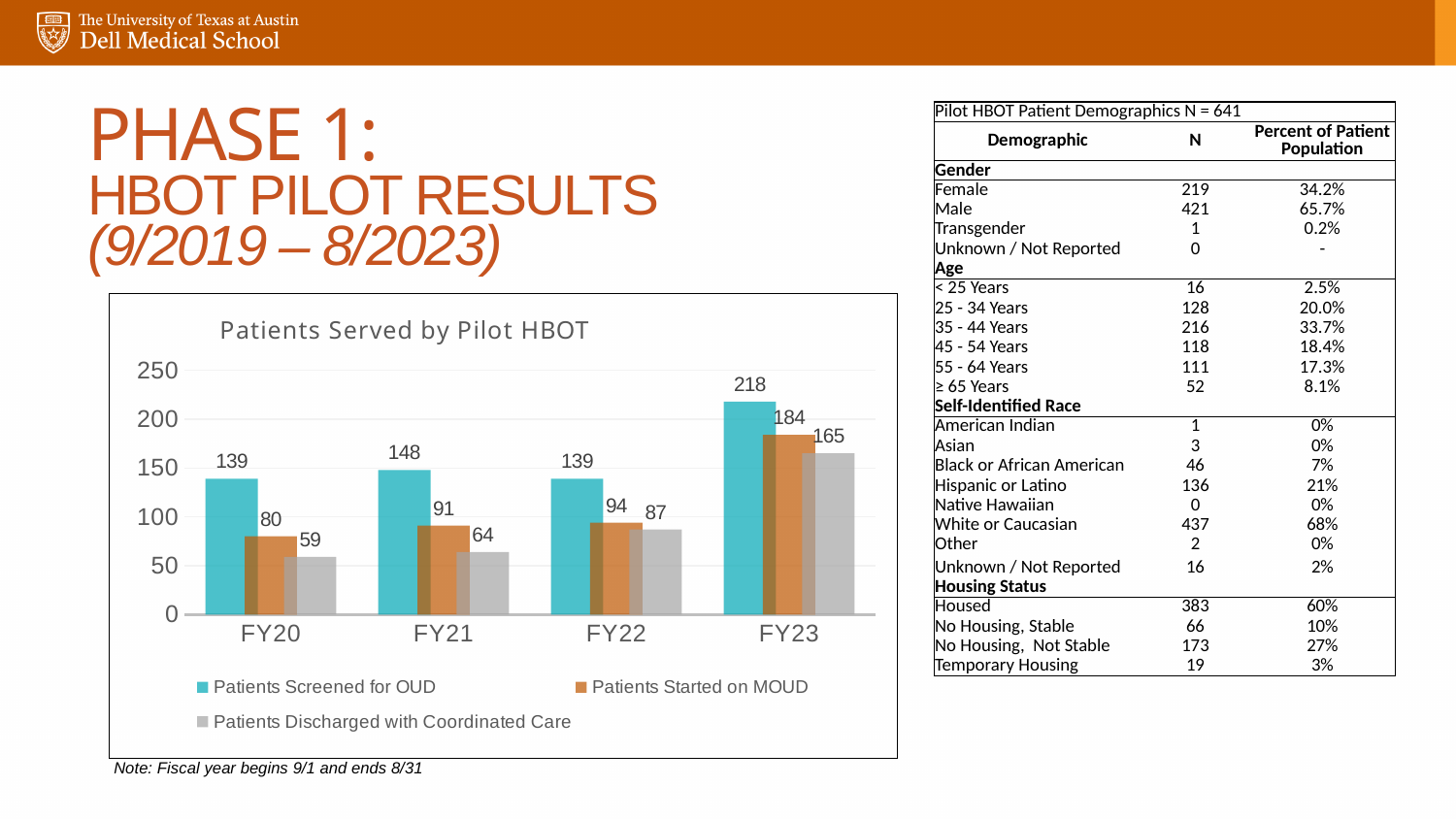
How many Patients Started on MOUD are shown for FY21? 91 In which fiscal year is the number of Patients Discharged with Coordinated Care lowest? FY20 What is the title of the chart on the slide? Patients Served by Pilot HBOT What is the value for Patients Screened for OUD in FY23? 218 What kind of chart is 'Patients Served by Pilot HBOT'? Bar chart In which fiscal year is the number of Patients Screened for OUD highest? FY23 What is the difference between Patients Screened for OUD and Patients Started on MOUD in FY23? 34 How many series does the chart's legend list? 3 Does the number of Patients Discharged with Coordinated Care rise or fall from FY20 to FY23? Rise What is the value for Patients Discharged with Coordinated Care in FY20? 59 Which is larger: Patients Started on MOUD in FY22 or Patients Started on MOUD in FY21? Patients Started on MOUD in FY22 How many fiscal years are shown on the x axis of the chart? 4